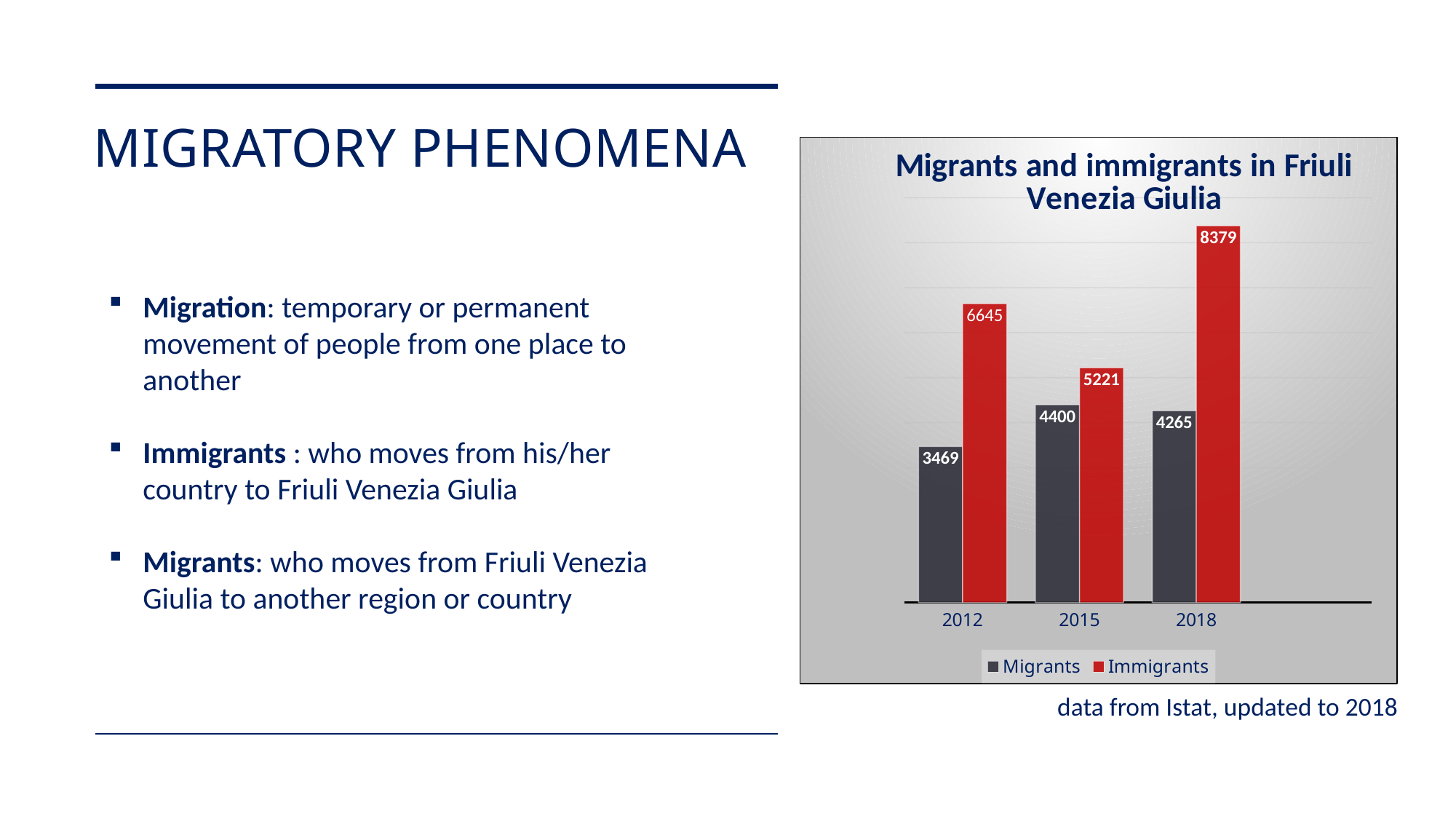
What is the value for Migrants in 2015? 4400 Which is larger in 2015, Migrants or Immigrants? Immigrants What is the difference between Immigrants and Migrants in 2018? 4114 In which year is the Migrants value lowest? 2012 What is the value for Migrants in 2012? 3469 How many series does the legend list? 2 How many years are shown on the x axis? 3 In which year is the Immigrants value highest? 2018 What is the value for Immigrants in 2018? 8379 What kind of chart is shown? Bar chart What is the value for Immigrants in 2012? 6645 What is the title of the chart? Migrants and immigrants in Friuli Venezia Giulia